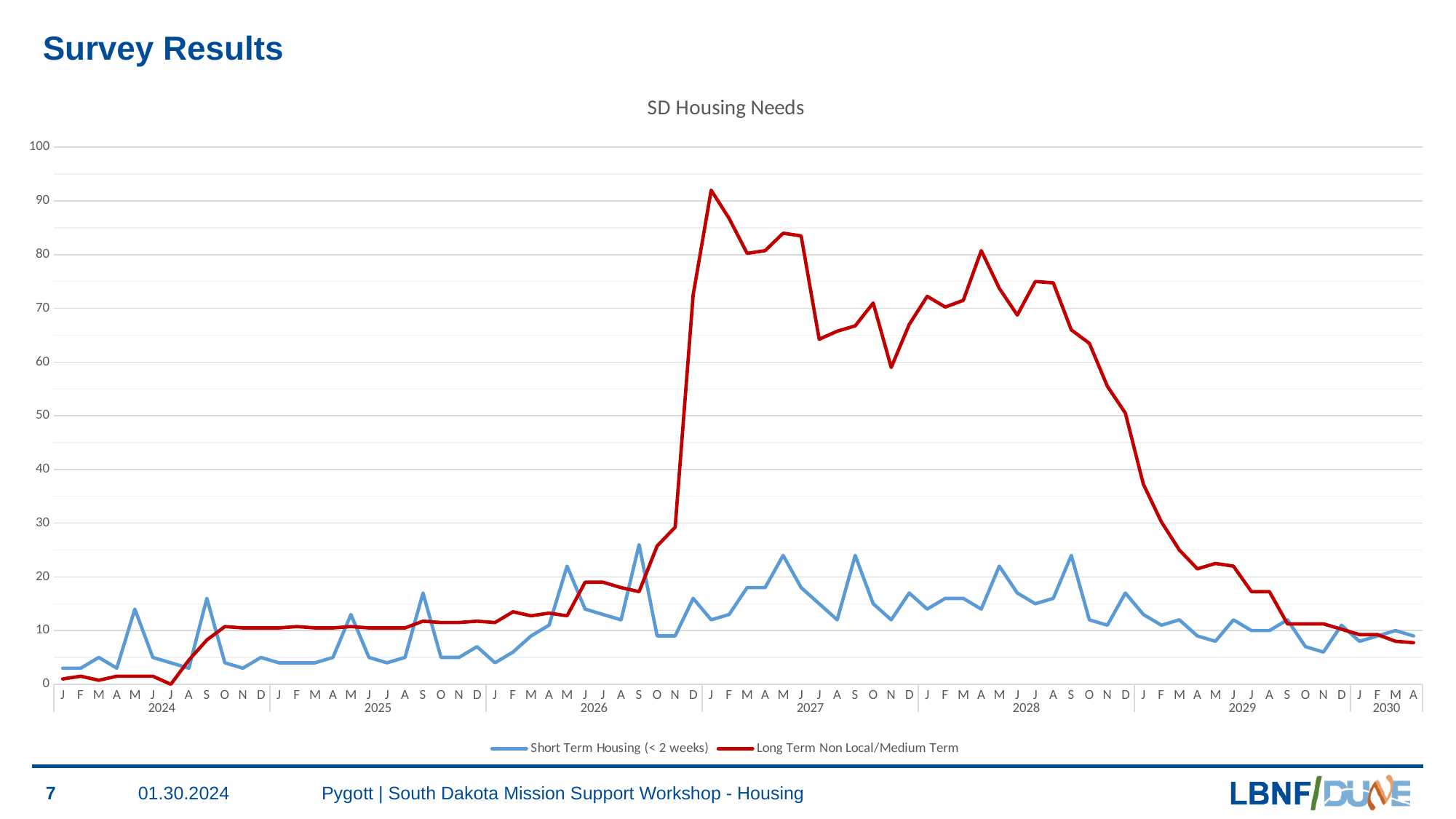
Which series is drawn in red? Long Term Non Local/Medium Term How many years are labeled along the x axis? 7 Does the Long Term Non Local/Medium Term series rise or fall overall from January 2027 to April 2030? fall Is the value for Long Term Non Local/Medium Term in July 2024 greater or less than 10? less Is the value for Long Term Non Local/Medium Term in January 2027 greater or less than 80? greater In January 2027, which series has the higher value, Short Term Housing (< 2 weeks) or Long Term Non Local/Medium Term? Long Term Non Local/Medium Term What is the title of the chart? SD Housing Needs Which series reaches the highest value anywhere on the chart? Long Term Non Local/Medium Term What kind of chart is shown on the slide? line chart In May 2024, which series has the higher value, Short Term Housing (< 2 weeks) or Long Term Non Local/Medium Term? Short Term Housing (< 2 weeks) How many series does the legend list? 2 Is the value for Short Term Housing (< 2 weeks) in September 2026 greater or less than 20? greater